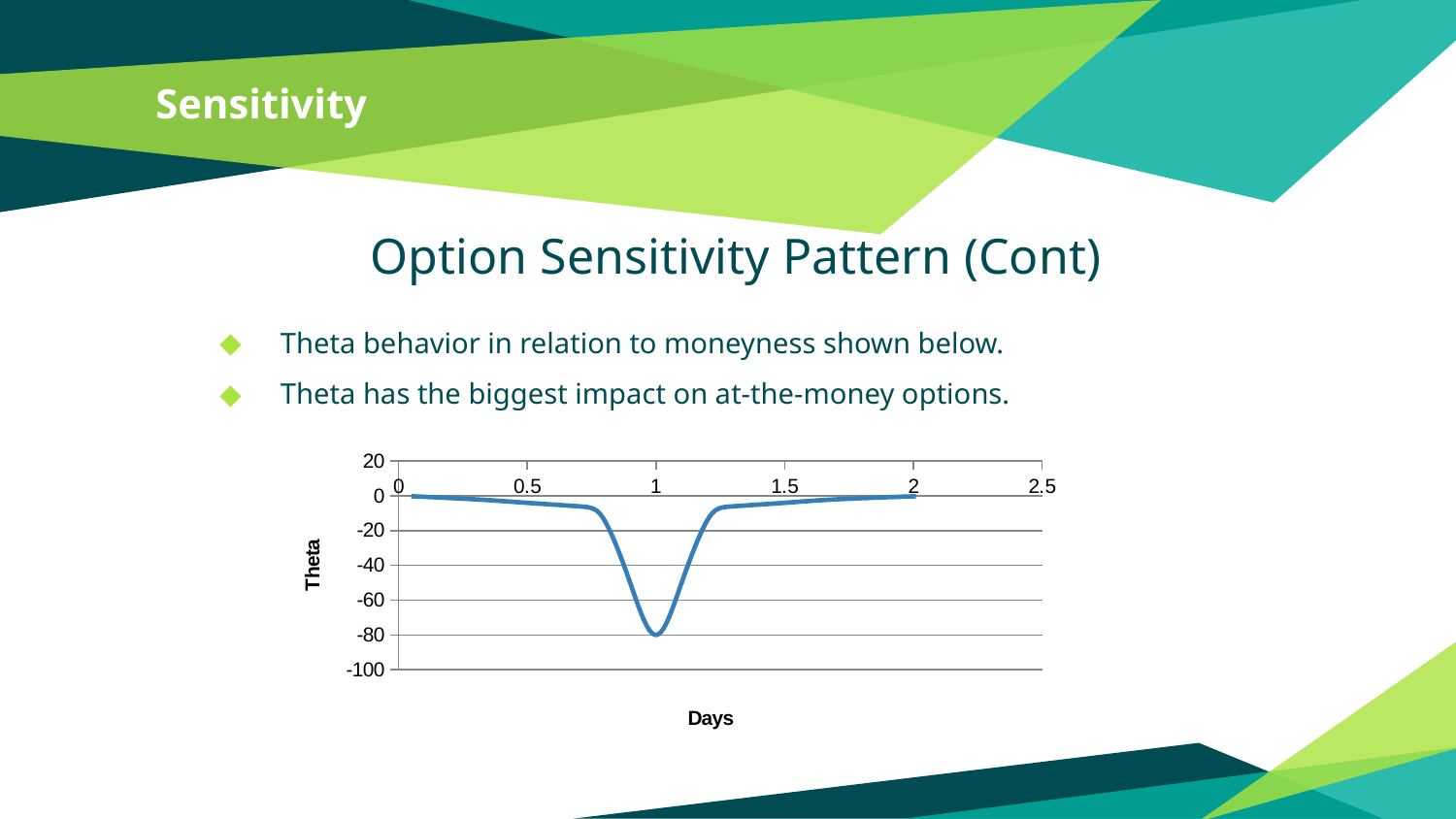
What is the highest value shown on the y axis of the chart? 20 Is the value of Theta at Days = 0.5 greater or less than -20? greater Is the value of Theta at Days = 1 greater or less than -60? less Does the Theta line rise or fall as Days increases from 1 to 2? rise What is the label of the x axis of the chart? Days At which value of Days does the Theta line reach its lowest point? 1 Does the Theta line rise or fall as Days increases from 0 to 1? fall Which is larger, the Theta value at Days = 0.5 or at Days = 1? Days = 0.5 What kind of chart is shown on the slide? line chart What is the largest value shown on the x axis of the chart? 2.5 Is the value of Theta at Days = 2 greater or less than -20? greater